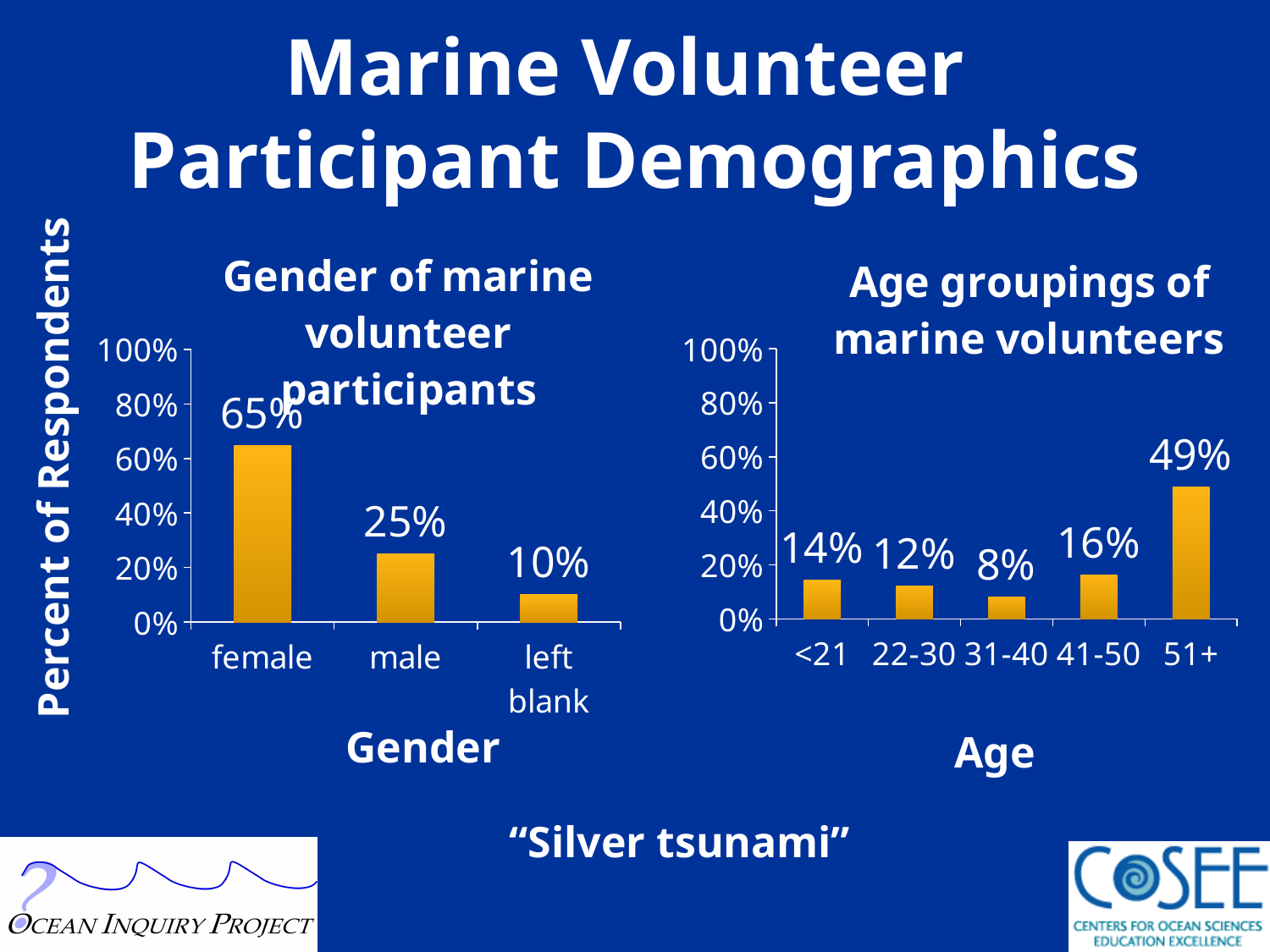
In the 'Age groupings of marine volunteers' chart, which age group has the highest value? 51+ In the 'Gender of marine volunteer participants' chart, which category has the lowest value? left blank In the 'Gender of marine volunteer participants' chart, what is the difference between the female and male values? 40% In the 'Gender of marine volunteer participants' chart, what is the value for male? 25% In the 'Age groupings of marine volunteers' chart, what is the difference between the 51+ and 41-50 values? 33% How many age groups are shown in the 'Age groupings of marine volunteers' chart? 5 What kind of chart is the 'Gender of marine volunteer participants' chart? bar chart In the 'Age groupings of marine volunteers' chart, which is larger, the value for <21 or the value for 22-30? <21 In the 'Gender of marine volunteer participants' chart, what is the value for female? 65% In the 'Age groupings of marine volunteers' chart, what is the value for the 51+ age group? 49% In the 'Age groupings of marine volunteers' chart, what is the value for the 31-40 age group? 8% In the 'Age groupings of marine volunteers' chart, which age group has the lowest value? 31-40